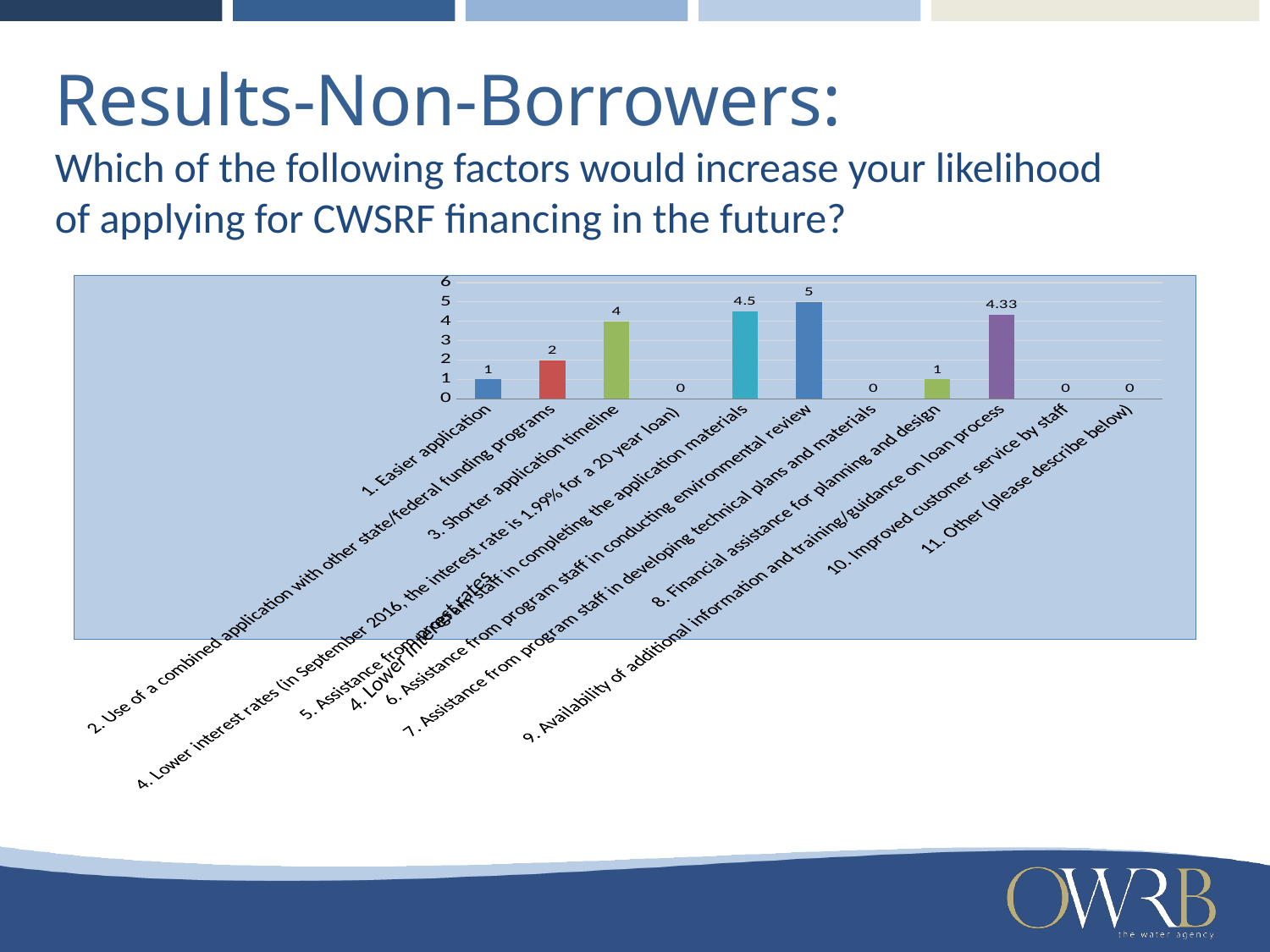
What kind of chart is shown on the slide? Bar chart What is the value for "1. Easier application"? 1 Which is larger, the value for "5. Assistance from program staff in completing the application materials" or the value for "9. Availability of additional information and training/guidance on loan process"? 5. Assistance from program staff in completing the application materials How many categories are shown on the x axis? 11 What is the difference between the values for "6. Assistance from program staff in conducting environmental review" and "3. Shorter application timeline"? 1 What is the value for "5. Assistance from program staff in completing the application materials"? 4.5 What is the value for "9. Availability of additional information and training/guidance on loan process"? 4.33 What is the value for "2. Use of a combined application with other state/federal funding programs"? 2 What is the value for "10. Improved customer service by staff"? 0 What is the value for "3. Shorter application timeline"? 4 Which category has the highest value? 6. Assistance from program staff in conducting environmental review How many categories have a value of 0? 4